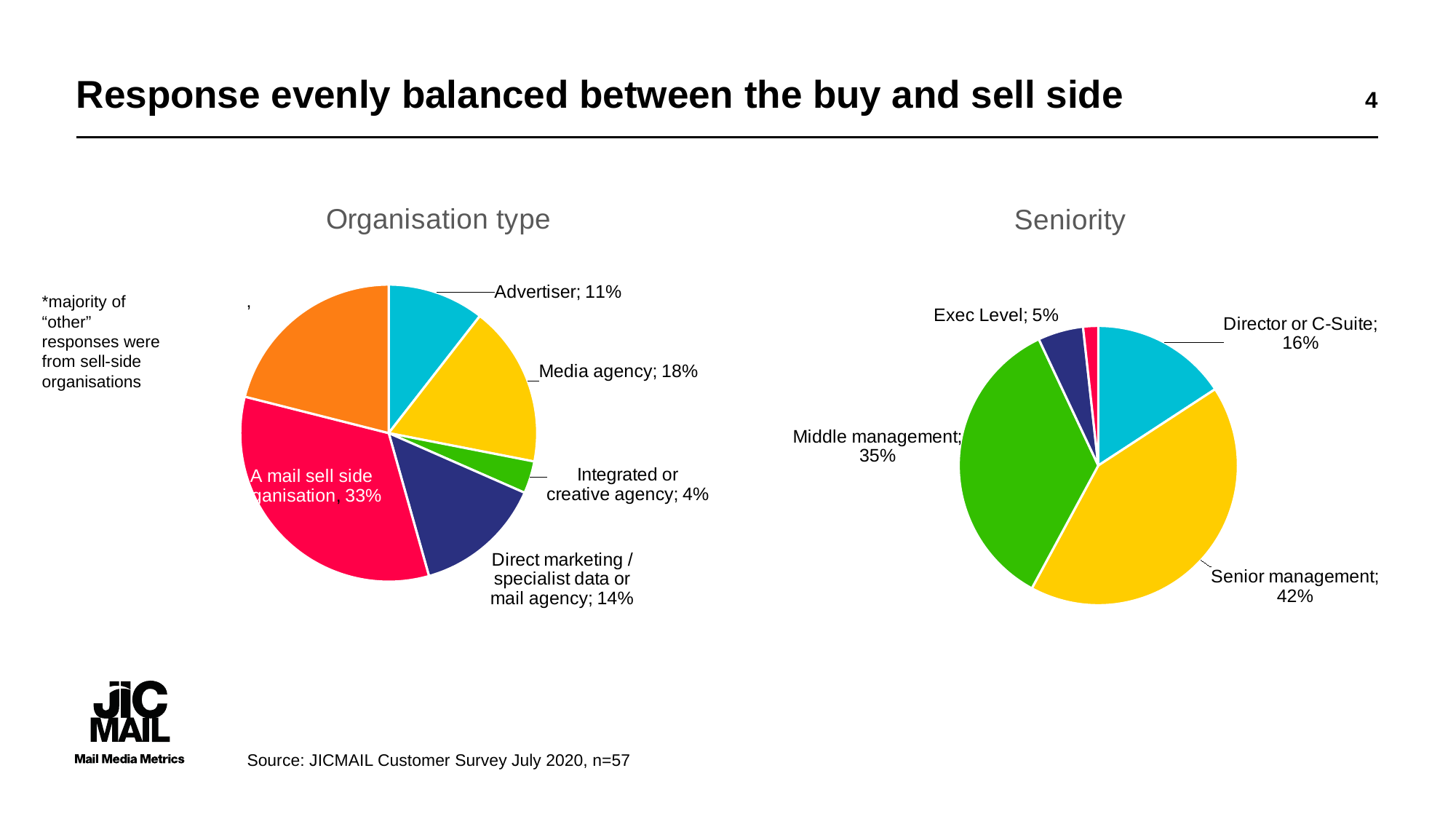
On the Organisation type chart, what percentage is shown for Direct marketing / specialist data or mail agency? 14% On the Organisation type chart, what is the difference between the Media agency share and the Advertiser share? 7% On the Organisation type chart, which labelled category has the smallest share? Integrated or creative agency On the Seniority chart, which is larger: Middle management or Director or C-Suite? Middle management What type of chart is the Seniority chart? Pie chart On the Organisation type chart, what share of responses came from advertisers? 11% On the Organisation type chart, which labelled category has the largest share? A mail sell side organisation On the Seniority chart, what is the difference between Senior management and Middle management? 7% On the Seniority chart, what percentage is shown for Exec Level? 5% On the Seniority chart, what percentage is shown for Senior management? 42% On the Organisation type chart, what percentage is shown for Integrated or creative agency? 4% On the Organisation type chart, what percentage is shown for Media agency? 18%